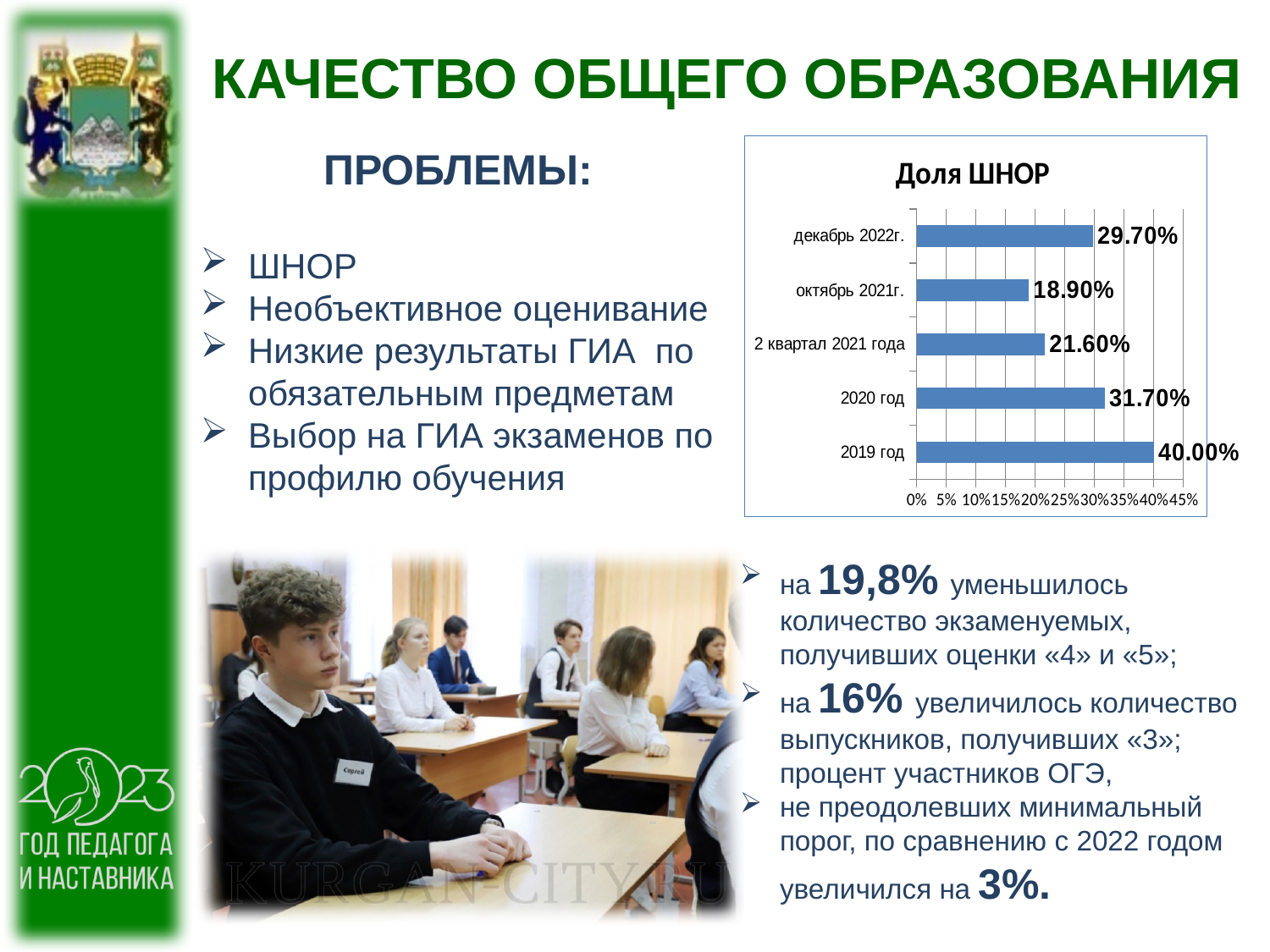
What is the value for декабрь 2022г. in the Доля ШНОР chart? 29.70% What is the value for 2019 год in the Доля ШНОР chart? 40.00% How many categories are shown in the Доля ШНОР chart? 5 What is the value for октябрь 2021г. in the Доля ШНОР chart? 18.90% Is the value for 2020 год in the Доля ШНОР chart greater or less than 30%? greater Which category has the highest value in the Доля ШНОР chart? 2019 год Which category has the lowest value in the Доля ШНОР chart? октябрь 2021г. Which is larger in the Доля ШНОР chart: the value for 2020 год or the value for декабрь 2022г.? 2020 год What is the value for 2 квартал 2021 года in the Доля ШНОР chart? 21.60% What is the difference between the values for 2019 год and 2020 год in the Доля ШНОР chart? 8.30% What is the title of the chart on the slide? Доля ШНОР What kind of chart is the Доля ШНОР chart? bar chart